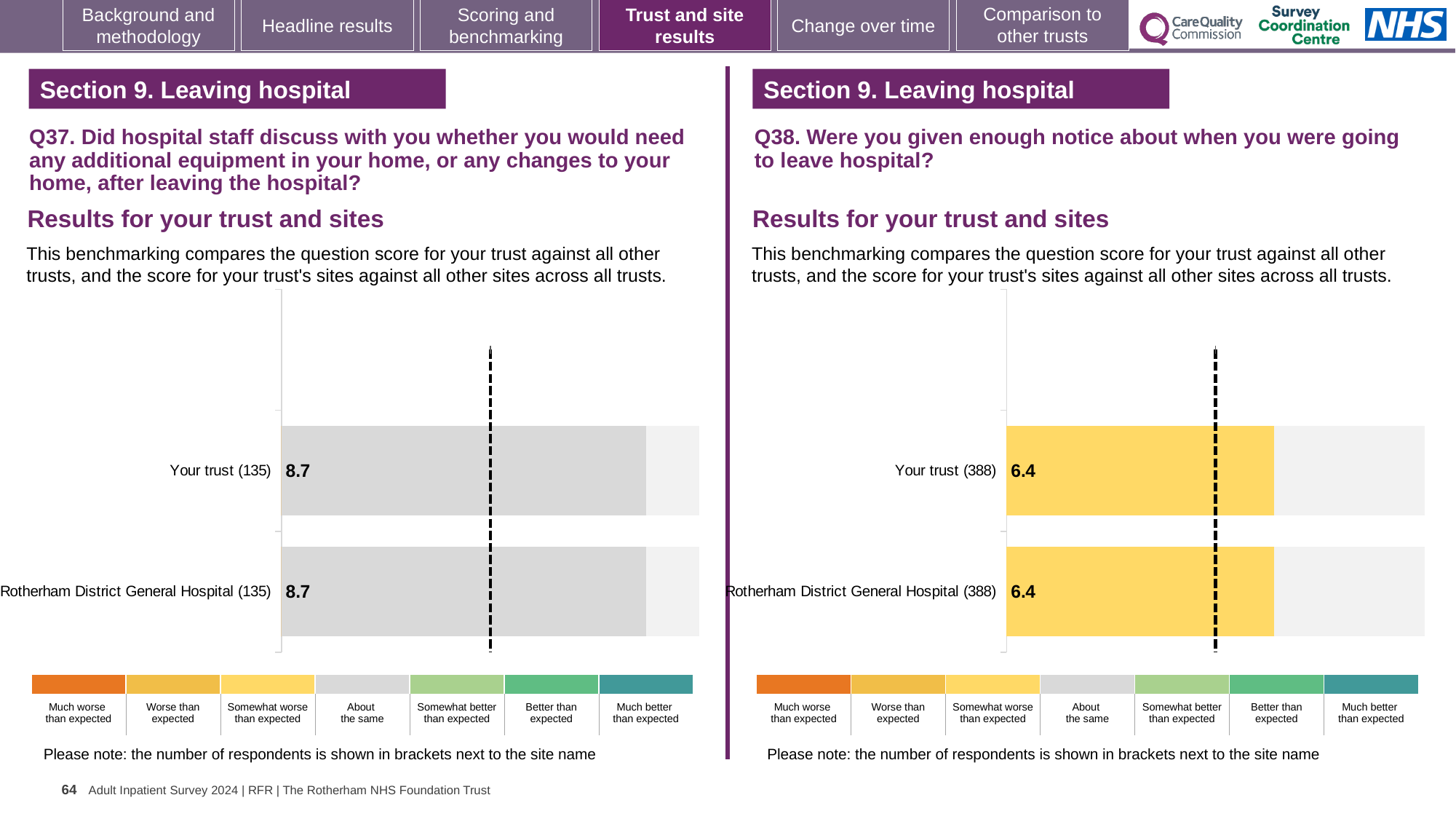
In the Q38 chart on the right, what is the score for Your trust? 6.4 In the Q37 chart on the left, what is the score for Rotherham District General Hospital? 8.7 What is the difference between the Your trust score in the Q37 chart and the Your trust score in the Q38 chart? 2.3 In the Q37 chart on the left, which benchmark category does the grey colour of the bars correspond to in the legend? About the same In the Q37 chart on the left, how many respondents are shown in brackets for Your trust? 135 Which is larger: the Your trust score in the Q37 chart on the left or the Your trust score in the Q38 chart on the right? Q37 chart (8.7) In the Q38 chart on the right, what is the score for Rotherham District General Hospital? 6.4 In the Q37 chart on the left, what is the score for Your trust? 8.7 How many bars are plotted in the Q37 chart on the left? 2 What kind of chart is used for the Q38 results on the right? Bar chart In the Q38 chart on the right, which benchmark category does the yellow colour of the bars correspond to in the legend? Somewhat worse than expected In the Q38 chart on the right, how many respondents are shown in brackets for Rotherham District General Hospital? 388